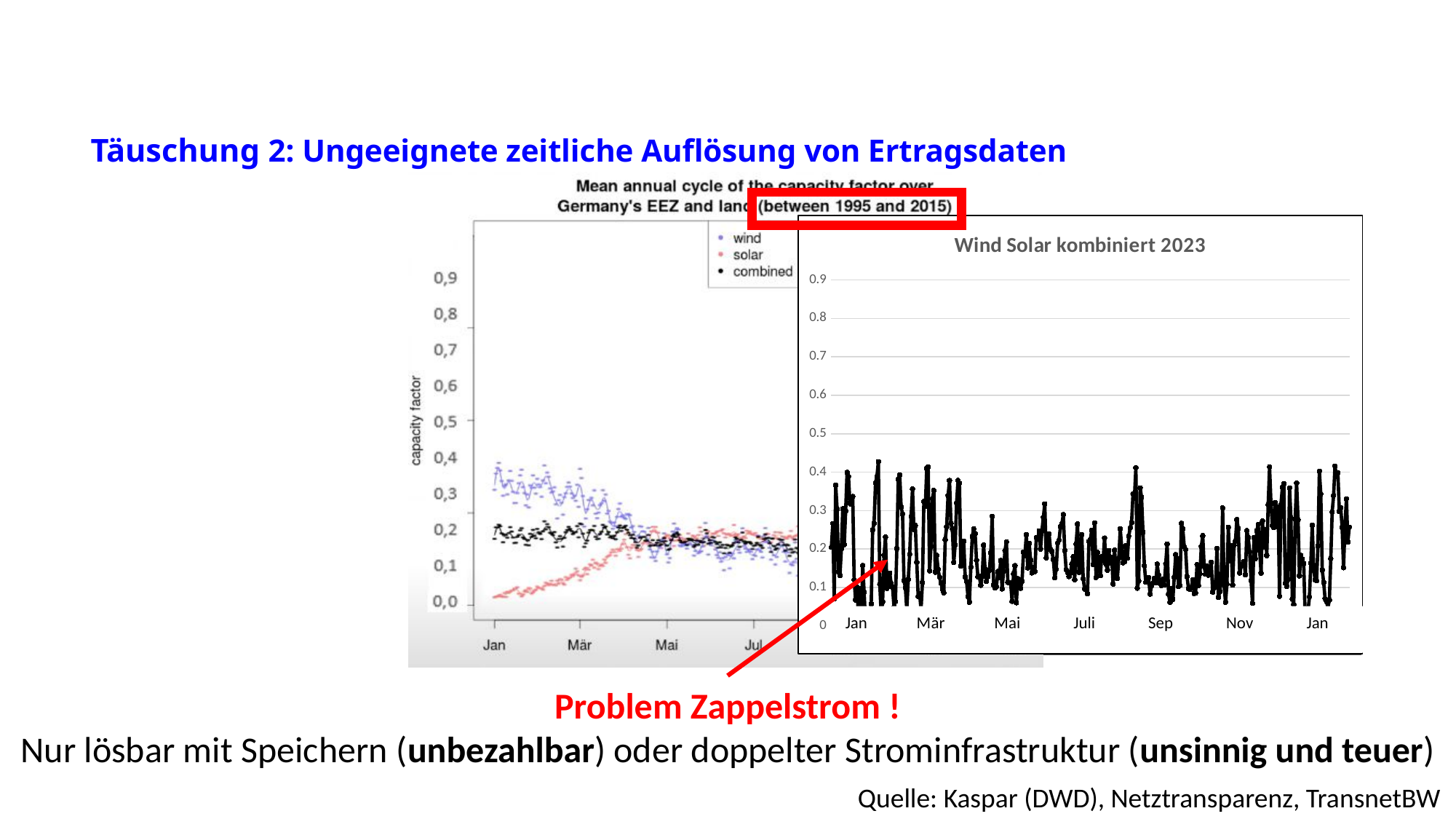
In the left chart (Mean annual cycle of the capacity factor), which series has the highest capacity factor in January? wind What is the title of the chart on the right side of the slide? Wind Solar kombiniert 2023 In the right chart, Wind Solar kombiniert 2023, what is the highest value shown on the y axis? 0.9 In the left chart (Mean annual cycle of the capacity factor), does the wind capacity factor rise or fall from January to May? fall What are the legend entries of the left chart (Mean annual cycle of the capacity factor)? wind, solar, combined How many series does the legend of the left chart (Mean annual cycle of the capacity factor) list? 3 What kind of chart is the right chart, Wind Solar kombiniert 2023? line chart In the left chart (Mean annual cycle of the capacity factor), does the solar capacity factor rise or fall from January to May? rise In the left chart (Mean annual cycle of the capacity factor), is the solar capacity factor in January greater or less than 0.1? less In the left chart (Mean annual cycle of the capacity factor), which series has the lowest capacity factor in January? solar In the left chart (Mean annual cycle of the capacity factor), is the wind capacity factor in January greater or less than 0.2? greater In the right chart, Wind Solar kombiniert 2023, is the highest plotted value greater or less than 0.5? less